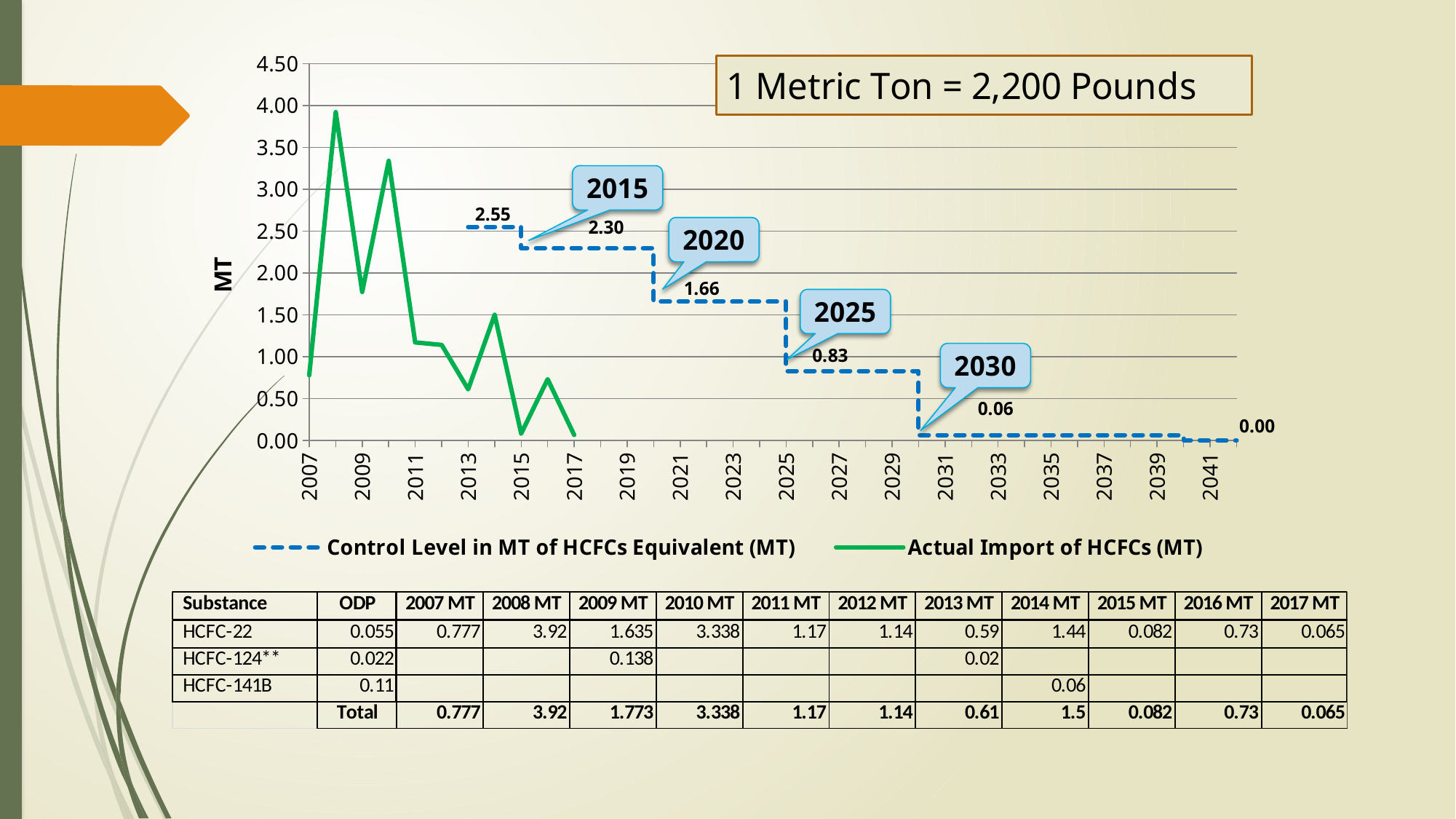
What is the difference between the 2020 Control Level (1.66) and the 2025 Control Level (0.83)? 0.83 What is the Control Level in MT of HCFCs Equivalent labelled at the 2030 step? 0.06 What is the Control Level in MT of HCFCs Equivalent labelled at the 2025 step? 0.83 What is the Control Level in MT of HCFCs Equivalent labelled at the 2015 step? 2.30 What is the Control Level in MT of HCFCs Equivalent labelled at the 2020 step? 1.66 What is the difference between the first Control Level value (2.55) and the 2015 Control Level value (2.30)? 0.25 Does the Control Level in MT of HCFCs Equivalent rise or fall over the years shown? fall What does the solid green line represent according to the legend? Actual Import of HCFCs (MT) Is the Actual Import of HCFCs in 2008 greater or less than 3.50? greater How many series does the chart legend list? 2 What type of chart is shown on the slide? line chart In which year does the Actual Import of HCFCs line reach its highest point? 2008